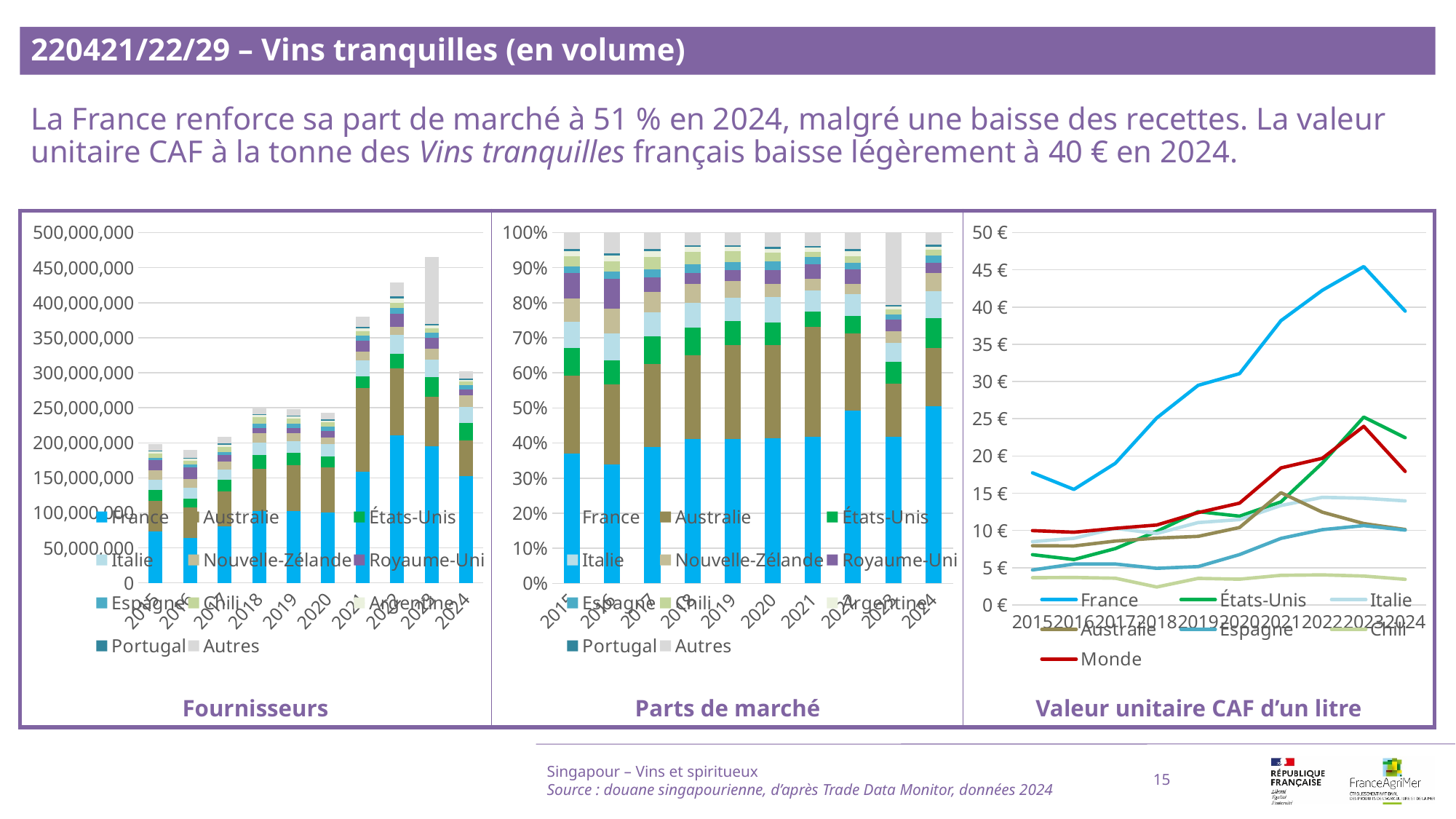
In the 'Fournisseurs' chart, is the total for 2022 greater or less than 400,000,000? greater In the 'Fournisseurs' chart, which year has the highest total stacked bar? 2023 In the 'Fournisseurs' chart, is the total for 2023 greater or less than 450,000,000? greater In the 'Valeur unitaire CAF d'un litre' chart, which is larger in 2020, France or Monde? France In the 'Valeur unitaire CAF d'un litre' chart, how many series does the legend list? 7 In the 'Valeur unitaire CAF d'un litre' chart, which series has the lowest value in 2024? Chili In the 'Fournisseurs' chart, how many years are shown on the x axis? 10 What kind of chart is the 'Fournisseurs' chart? bar chart What kind of chart is the 'Valeur unitaire CAF d'un litre' chart? line chart In the 'Parts de marché' chart, how many series does the legend list? 11 In the 'Valeur unitaire CAF d'un litre' chart, is the value for France in 2023 greater or less than 40 €? greater In the 'Valeur unitaire CAF d'un litre' chart, which series has the highest value in 2024? France